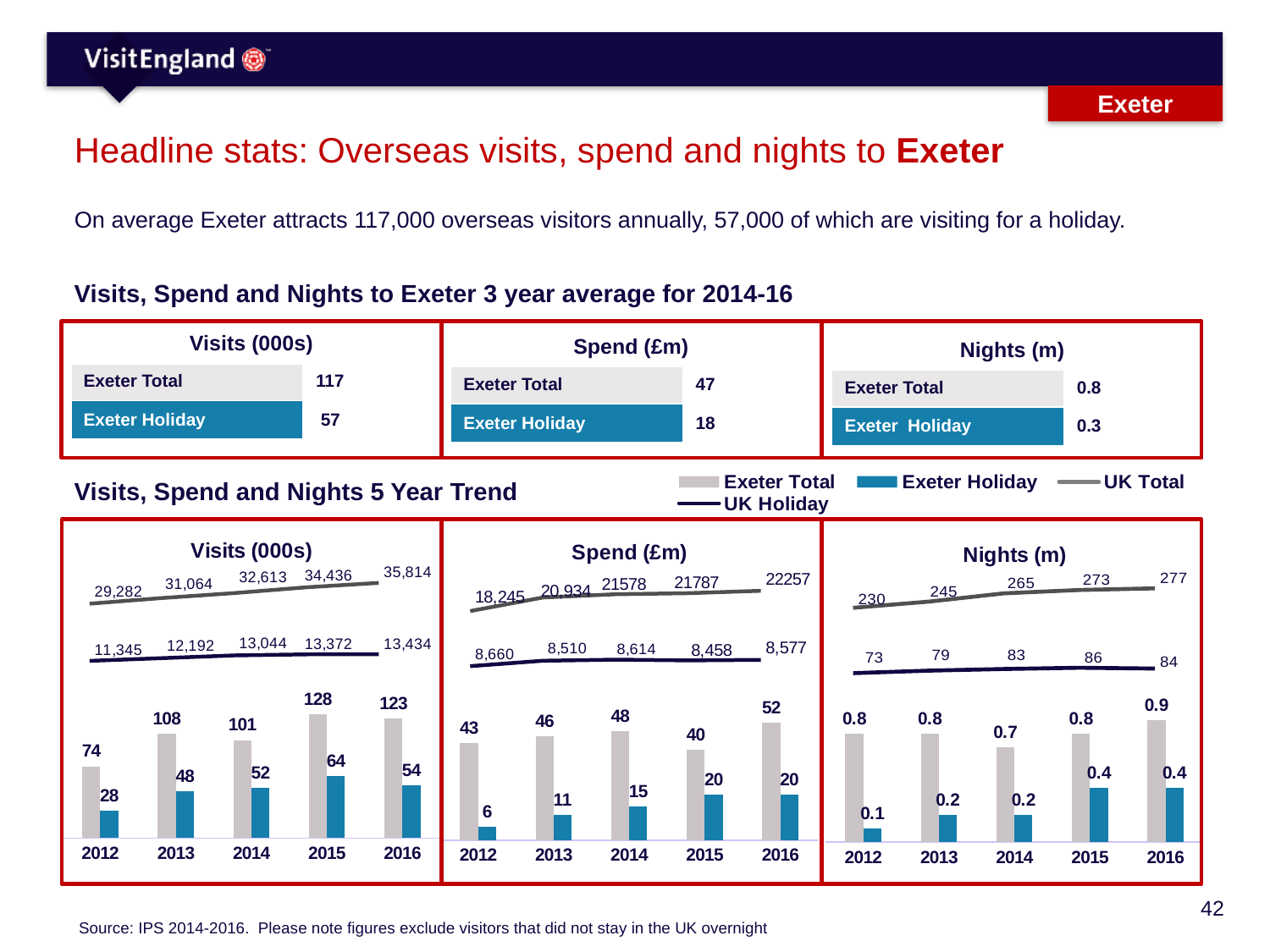
In the Spend (£m) 5 year trend chart, what is the UK Holiday value for 2012? 8,660 In the Visits (000s) 5 year trend chart, what is the UK Total value for 2014? 32,613 How many years are shown on the x axis of the Visits (000s) 5 year trend chart? 5 In the Spend (£m) 5 year trend chart, is the Exeter Total value larger in 2014 or 2015? 2014 In the Spend (£m) 5 year trend chart, which year has the highest Exeter Total value? 2016 In the Visits (000s) 5 year trend chart, what is the difference between Exeter Total and Exeter Holiday in 2016? 69 In the Visits (000s) 5 year trend chart, what is the Exeter Total value for 2015? 128 In the Visits (000s) 5 year trend chart, which year has the lowest Exeter Holiday value? 2012 In the Spend (£m) 5 year trend chart, what is the Exeter Holiday value for 2014? 15 In the Nights (m) 5 year trend chart, what is the UK Total value for 2016? 277 How many series does the legend above the 5 Year Trend charts list? 4 In the Nights (m) 5 year trend chart, what is the Exeter Holiday value for 2012? 0.1